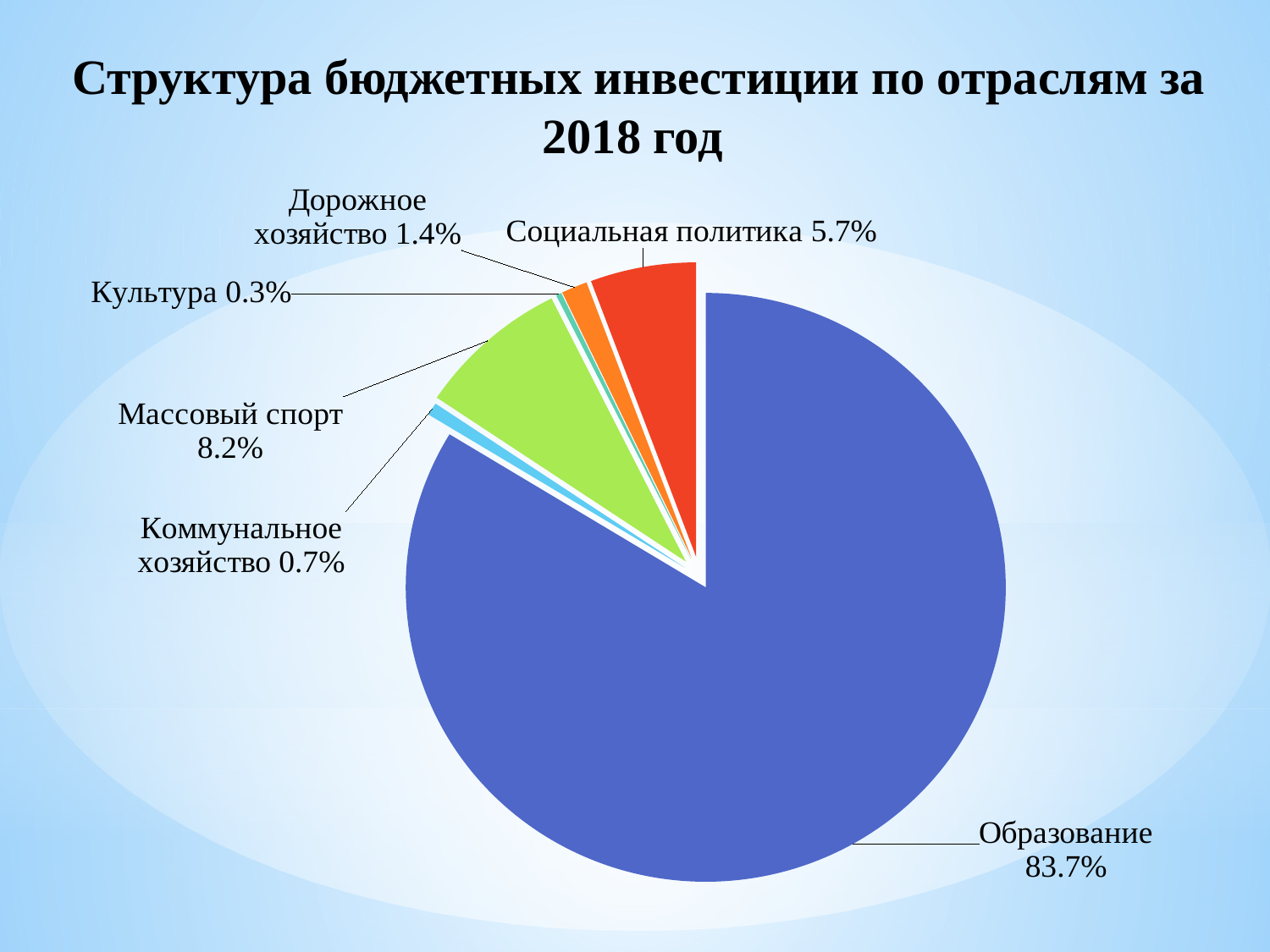
How many sectors (slices) are shown in the pie chart? 6 Which has a larger share: Дорожное хозяйство or Коммунальное хозяйство? Дорожное хозяйство Which sector has the smallest share of budget investments? Культура What share of budget investments went to Массовый спорт? 8.2% What share of budget investments went to Образование (education)? 83.7% What is the title of the chart? Структура бюджетных инвестиции по отраслям за 2018 год Which sector has the largest share of budget investments? Образование What is the difference in share between Массовый спорт and Социальная политика? 2.5 percentage points What kind of chart is shown on the slide? pie chart What share of budget investments went to Социальная политика? 5.7% What share of budget investments went to Коммунальное хозяйство? 0.7% What share of budget investments went to Дорожное хозяйство? 1.4%